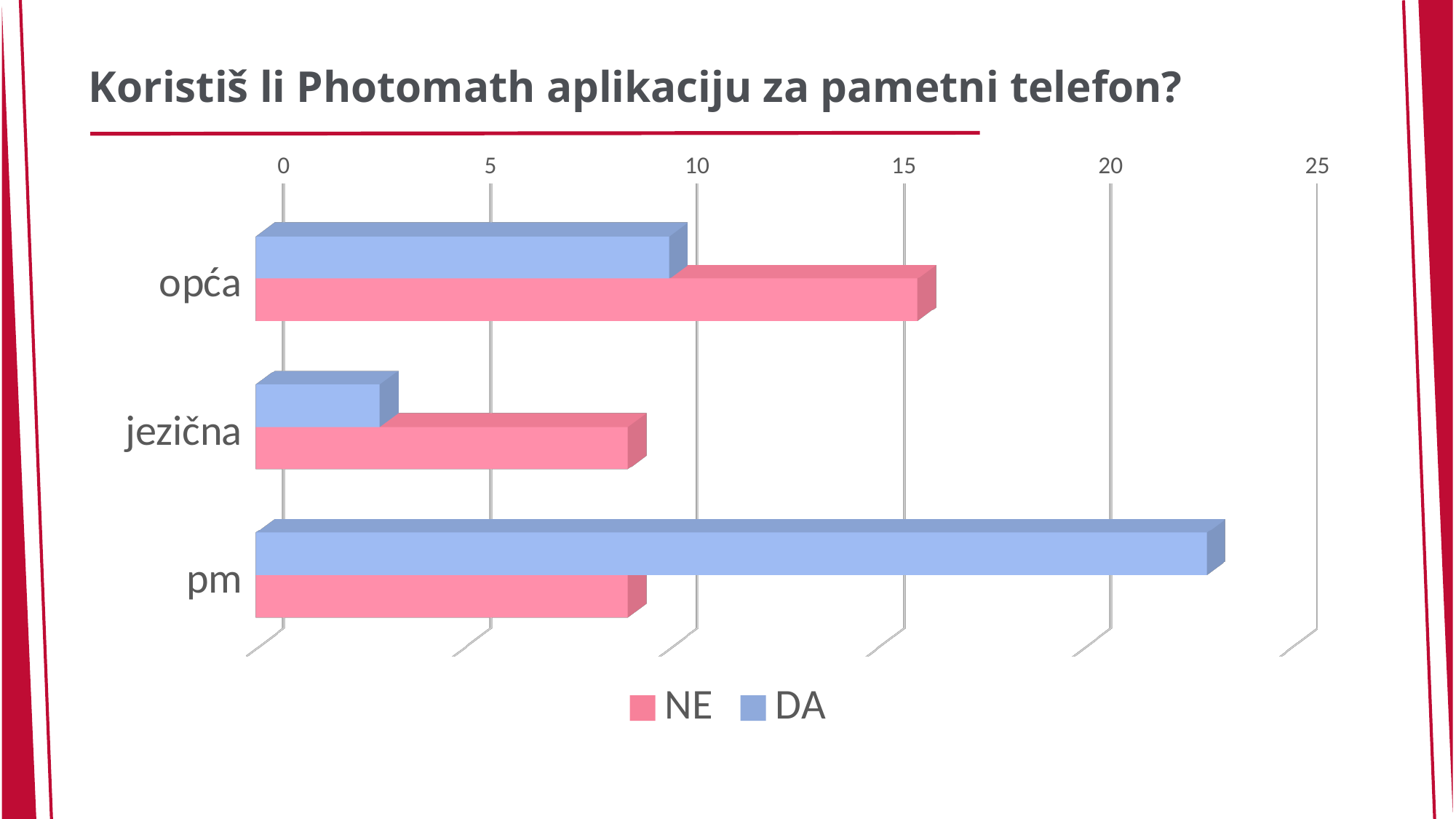
Which category has the highest DA value? pm What kind of chart is shown on the slide? bar chart Is the DA value for jezična greater or less than 5? less For opća, which is larger, NE or DA? NE For pm, which is larger, NE or DA? DA Is the NE value for opća greater or less than 10? greater How many categories are shown on the chart? 3 Is the DA value for pm greater or less than 20? greater Which category has the lowest DA value? jezična Which category has the highest NE value? opća What colour represents the DA series in the chart? blue How many series does the legend list? 2